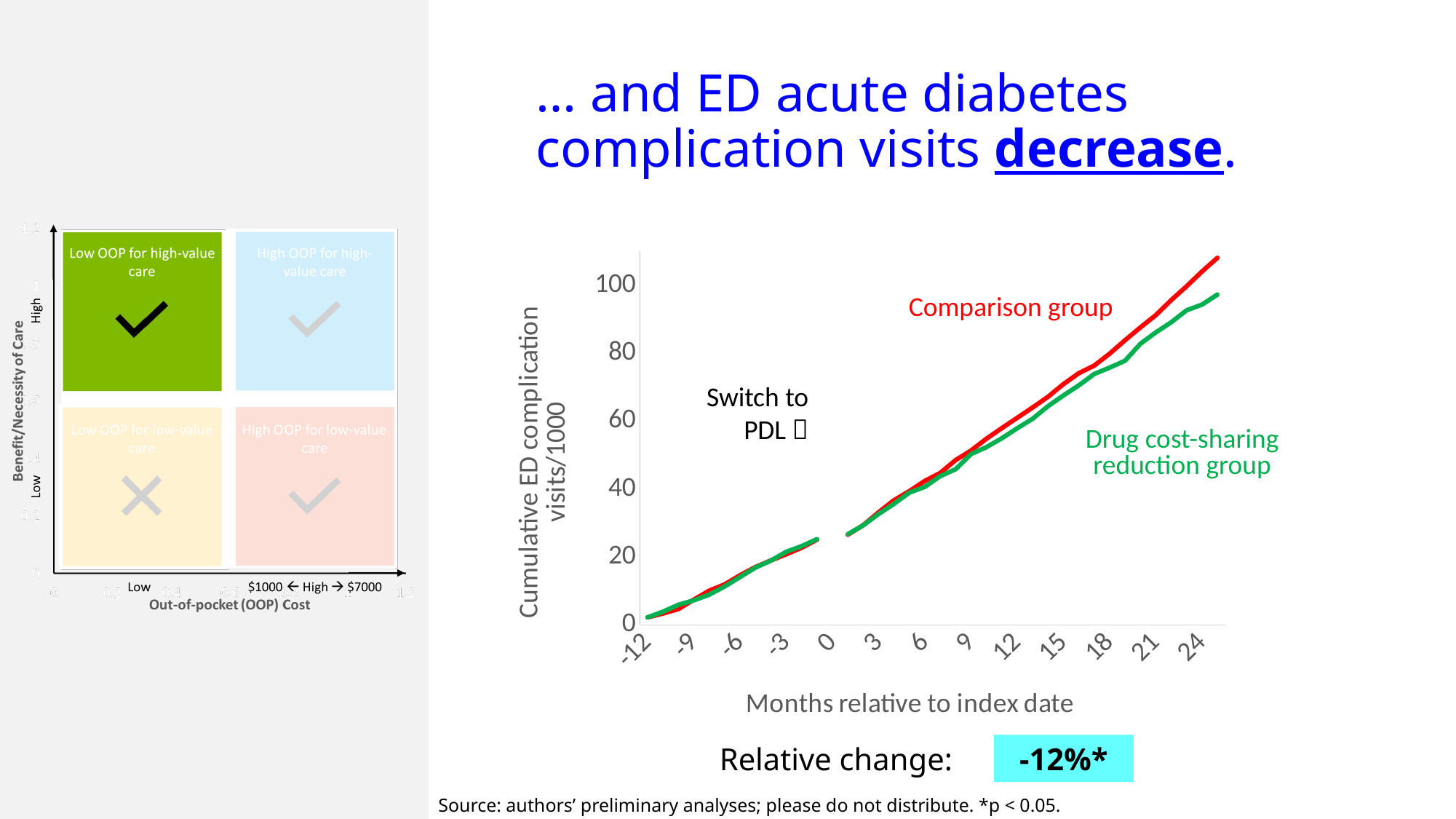
How many series are plotted in the cumulative ED complication visits chart? 2 In the cumulative ED complication visits chart, is the value for the Drug cost-sharing reduction group at month 24 greater or less than 100? less In the cumulative ED complication visits chart, which group has the higher value at month 24? Comparison group What kind of chart is shown on the right side of the slide? line chart What relative change is reported below the cumulative ED complication visits chart? -12%* In the cumulative ED complication visits chart, which group has the lower cumulative value at the end of the follow-up period? Drug cost-sharing reduction group In the cumulative ED complication visits chart, is the value for the Comparison group at month 12 greater or less than 40? greater How many tick labels are shown on the x axis of the cumulative ED complication visits chart? 13 In the cumulative ED complication visits chart, do the values rise or fall as months relative to index date increase? rise In the cumulative ED complication visits chart, is the value for the Comparison group at month 18 greater or less than 60? greater What colour is the Comparison group line in the cumulative ED complication visits chart? red